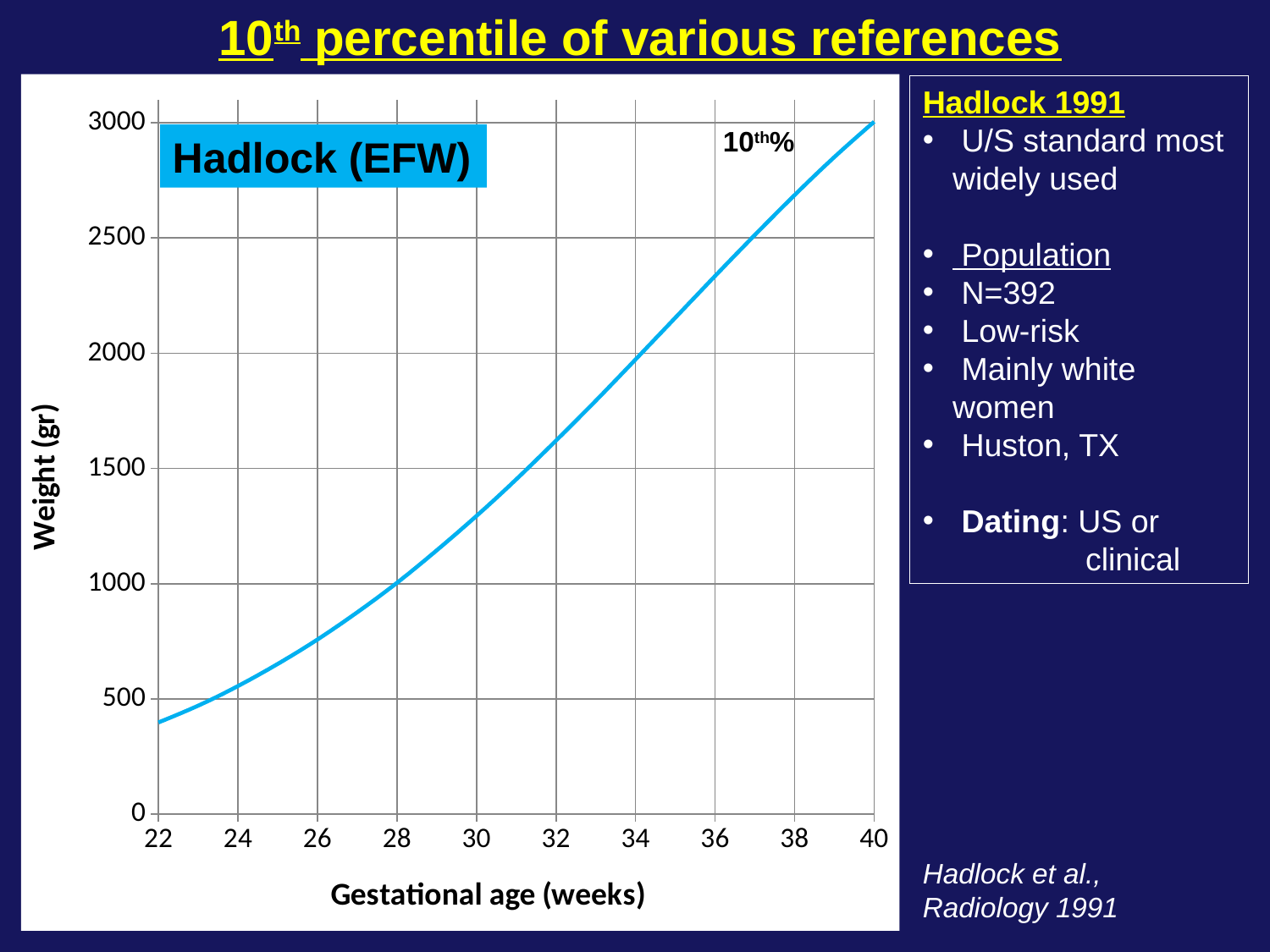
At which gestational age shown on the x axis is the weight lowest? 22 Is the weight at 38 weeks greater or less than 2500? greater What kind of chart is shown on the slide? line chart Is the weight at 30 weeks greater or less than 1000? greater At which gestational age shown on the x axis is the weight highest? 40 Is the weight at 22 weeks greater or less than 500? less What is the title shown in the box on the chart? Hadlock (EFW) What is the label of the y axis? Weight (gr) Does the weight rise or fall as gestational age increases along the x axis? rises